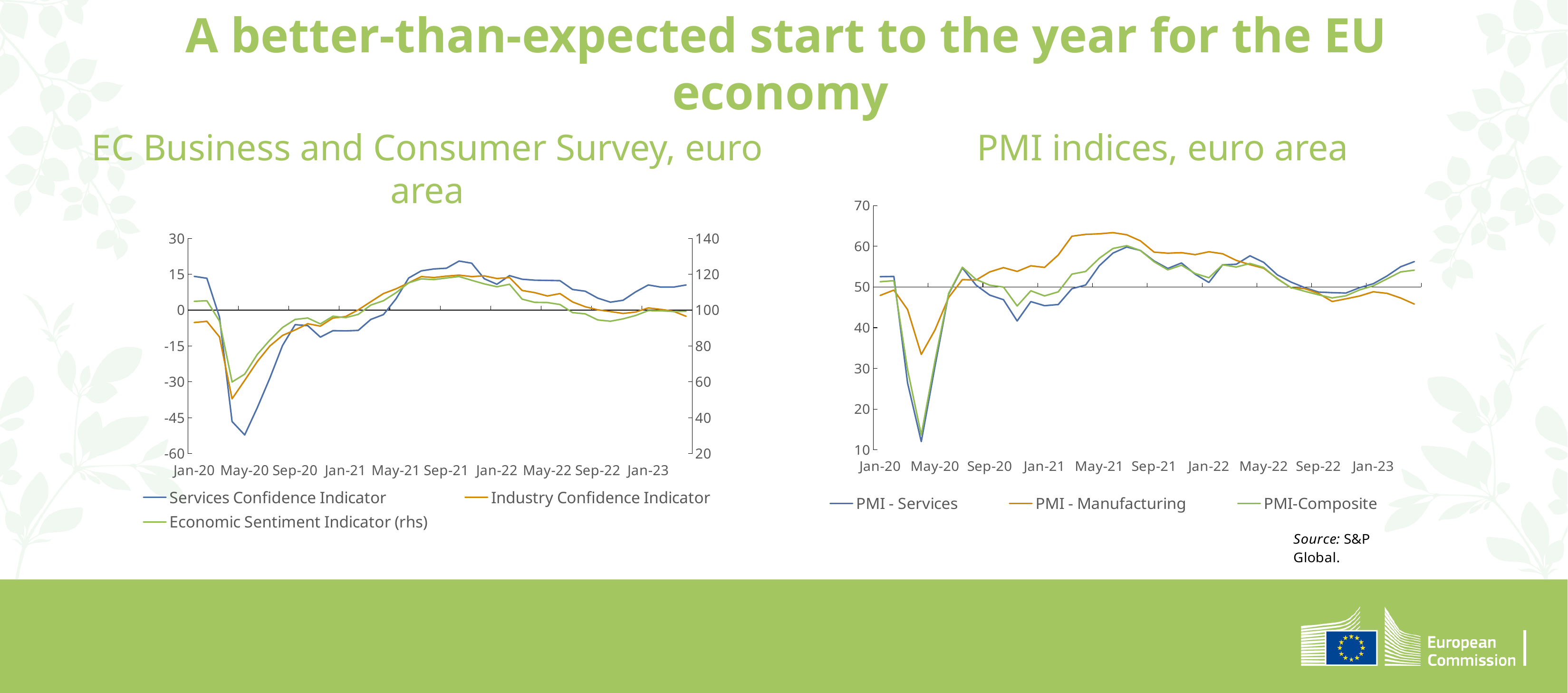
In the 'EC Business and Consumer Survey, euro area' chart, which is lower around May-20: the Services Confidence Indicator or the Industry Confidence Indicator? Services Confidence Indicator What kind of chart is the 'PMI indices, euro area' chart? Line chart How many series does the legend of the 'PMI indices, euro area' chart list? 3 In the 'PMI indices, euro area' chart, which series has the highest value around May-20? PMI - Manufacturing In the 'EC Business and Consumer Survey, euro area' chart, is the value for the Services Confidence Indicator around May-20 greater or less than -30? less What kind of chart is the 'EC Business and Consumer Survey, euro area' chart? Line chart In the 'PMI indices, euro area' chart, is the value for PMI - Manufacturing around May-20 greater or less than 30? greater How many series does the legend of the 'EC Business and Consumer Survey, euro area' chart list? 3 Which series in the 'EC Business and Consumer Survey, euro area' chart is plotted on the right-hand axis? Economic Sentiment Indicator (rhs) In the 'PMI indices, euro area' chart, does PMI - Services rise or fall between Sep-22 and Jan-23? Rise